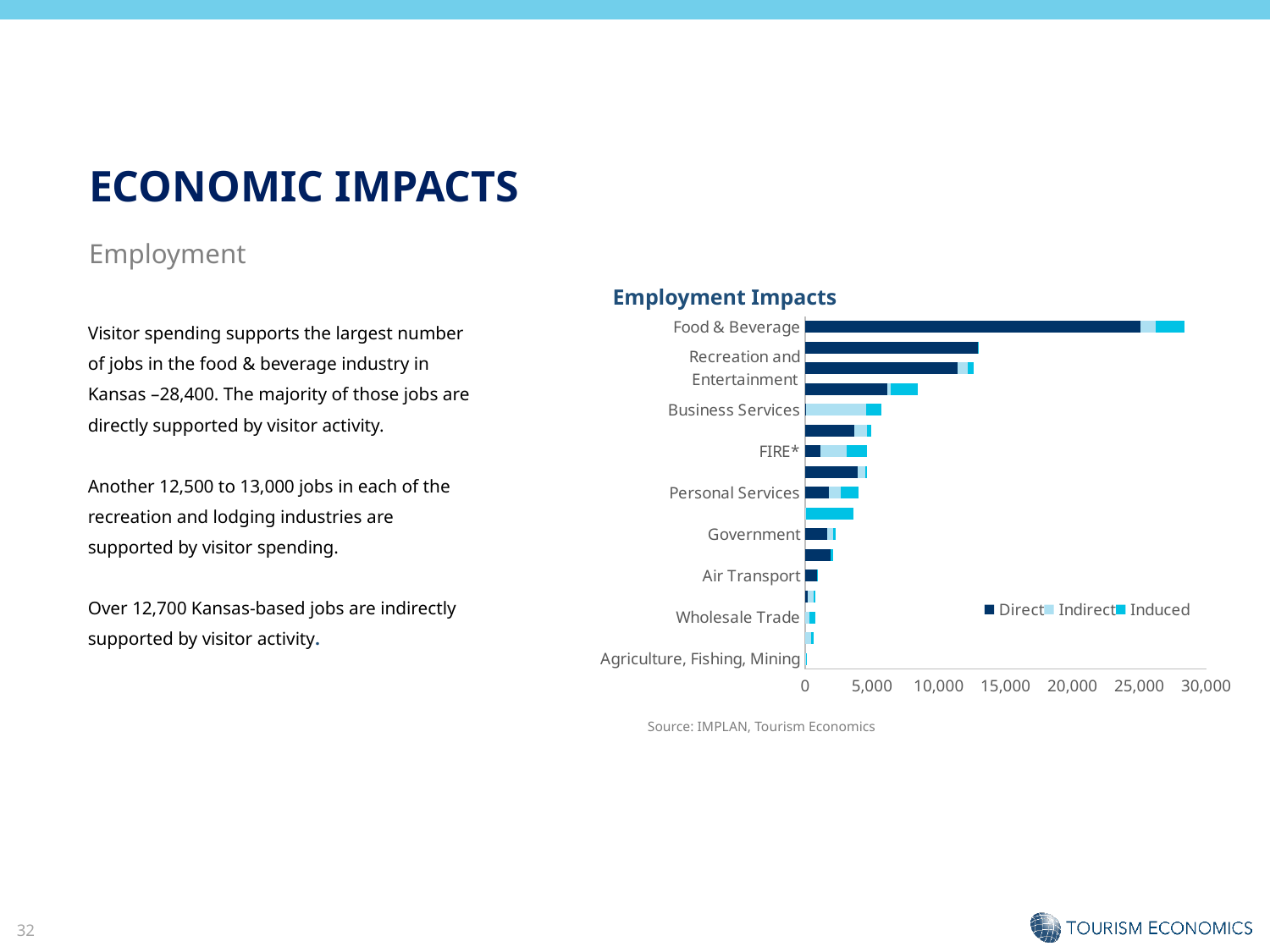
Which category has the longest bar in the Employment Impacts chart? Food & Beverage Which has the longer bar, Recreation and Entertainment or Air Transport? Recreation and Entertainment Which labeled category has the shortest bar in the Employment Impacts chart? Agriculture, Fishing, Mining What is the highest value shown on the horizontal axis of the Employment Impacts chart? 30,000 Is the total bar length for Recreation and Entertainment greater or less than 10,000? greater What kind of chart is the Employment Impacts chart? bar chart Is the total bar length for Government greater or less than 5,000? less Is the total bar length for Business Services greater or less than 10,000? less How many series does the legend of the Employment Impacts chart list? 3 What are the three legend entries in the Employment Impacts chart? Direct, Indirect, Induced Which has the longer bar, Food & Beverage or Business Services? Food & Beverage